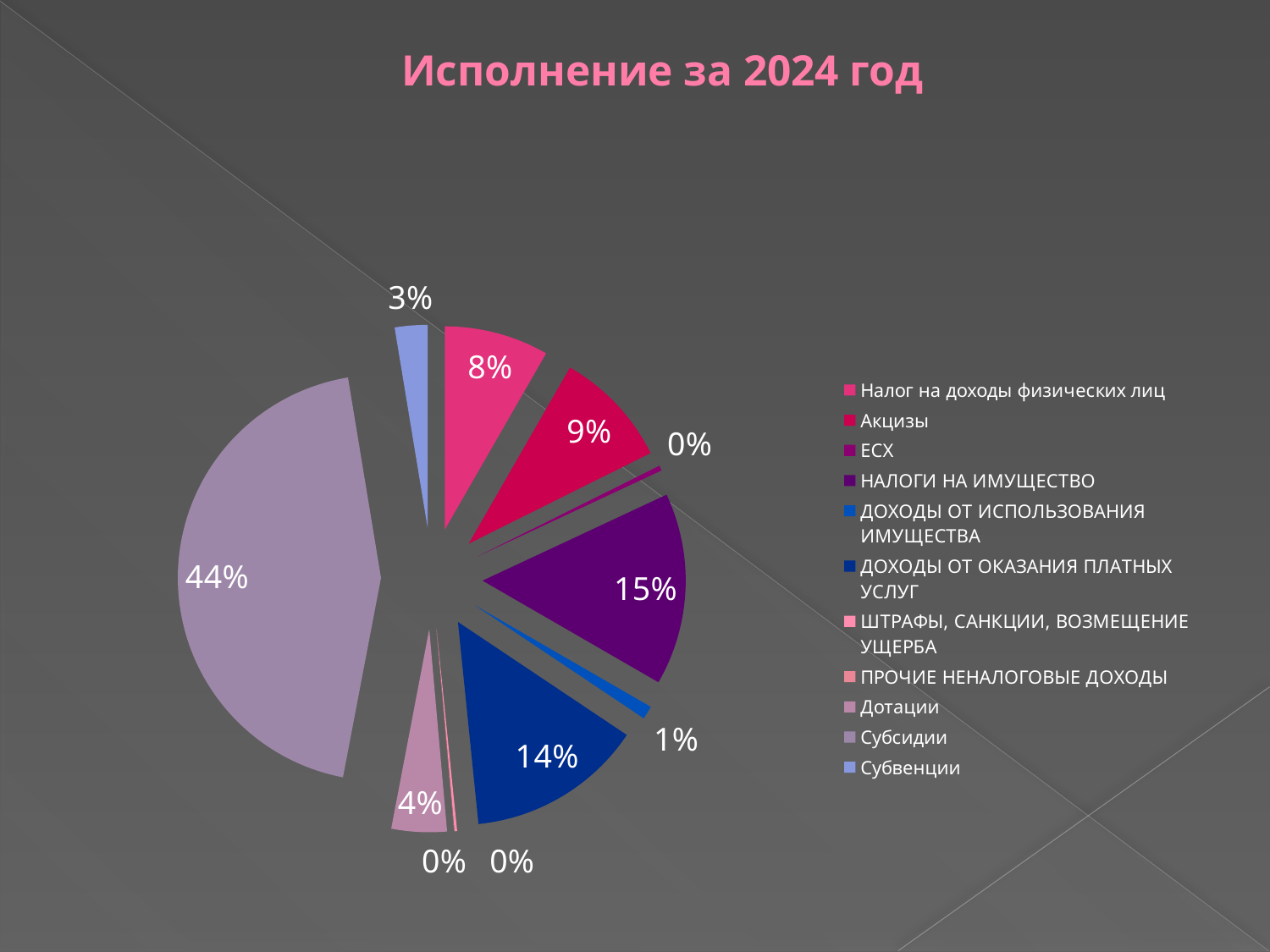
What is the title of the chart? Исполнение за 2024 год What share of the pie is НАЛОГИ НА ИМУЩЕСТВО? 15% What share of the pie is Акцизы? 9% What share of the pie is Дотации? 4% What share of the pie is Субвенции? 3% Which is larger, the share for Акцизы or the share for Налог на доходы физических лиц? Акцизы What share of the pie is ДОХОДЫ ОТ ОКАЗАНИЯ ПЛАТНЫХ УСЛУГ? 14% How many categories does the legend list? 11 What share of the pie is Субсидии? 44% What is the difference in percentage points between the share for Субсидии and the share for НАЛОГИ НА ИМУЩЕСТВО? 29 Which category has the largest share of the pie? Субсидии What kind of chart is shown on the slide? pie chart